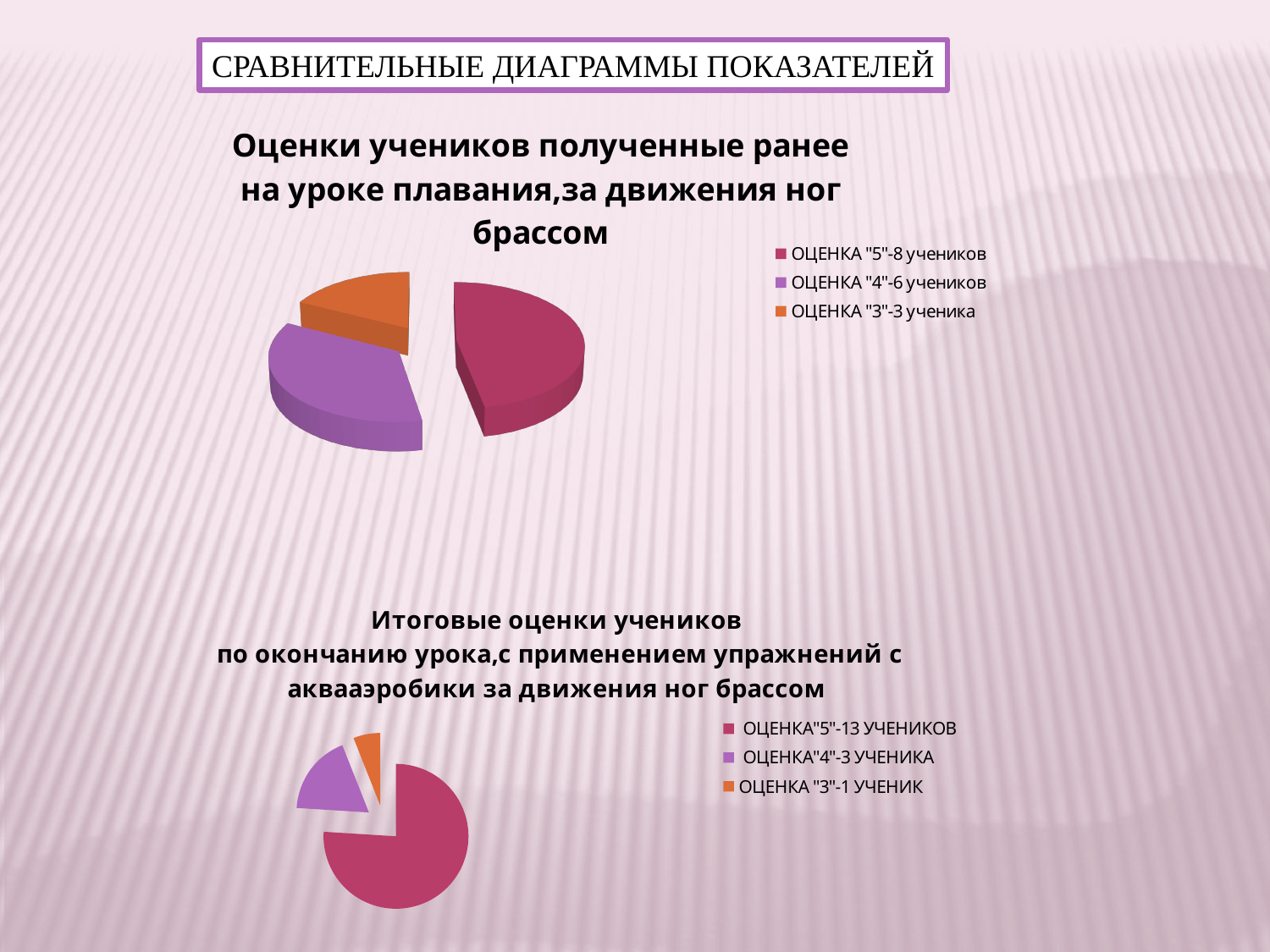
In the top chart (grades received earlier in the swimming lesson), what is the difference between the number of students with grade "5" and grade "4"? 2 What type of chart is the top chart on the slide? pie chart In the top chart (grades received earlier in the swimming lesson), how many students received grade "4"? 6 учеников How many slices does the top pie chart have? 3 In the bottom chart (final grades after the lesson with aqua aerobics exercises), what is the difference between the number of students with grade "5" and grade "4"? 10 In the top chart (grades received earlier in the swimming lesson), which grade category has the largest slice? ОЦЕНКА "5" In the top chart (grades received earlier in the swimming lesson), how many students received grade "3"? 3 ученика In the bottom chart (final grades after the lesson with aqua aerobics exercises), which grade category has the smallest slice? ОЦЕНКА "3" In the bottom chart (final grades after the lesson with aqua aerobics exercises), how many students received grade "3"? 1 УЧЕНИК In the bottom chart (final grades after the lesson with aqua aerobics exercises), how many students received grade "5"? 13 УЧЕНИКОВ Which is larger: the number of students with grade "5" in the top chart or in the bottom chart? bottom chart In the top chart (grades received earlier in the swimming lesson), how many students received grade "5"? 8 учеников